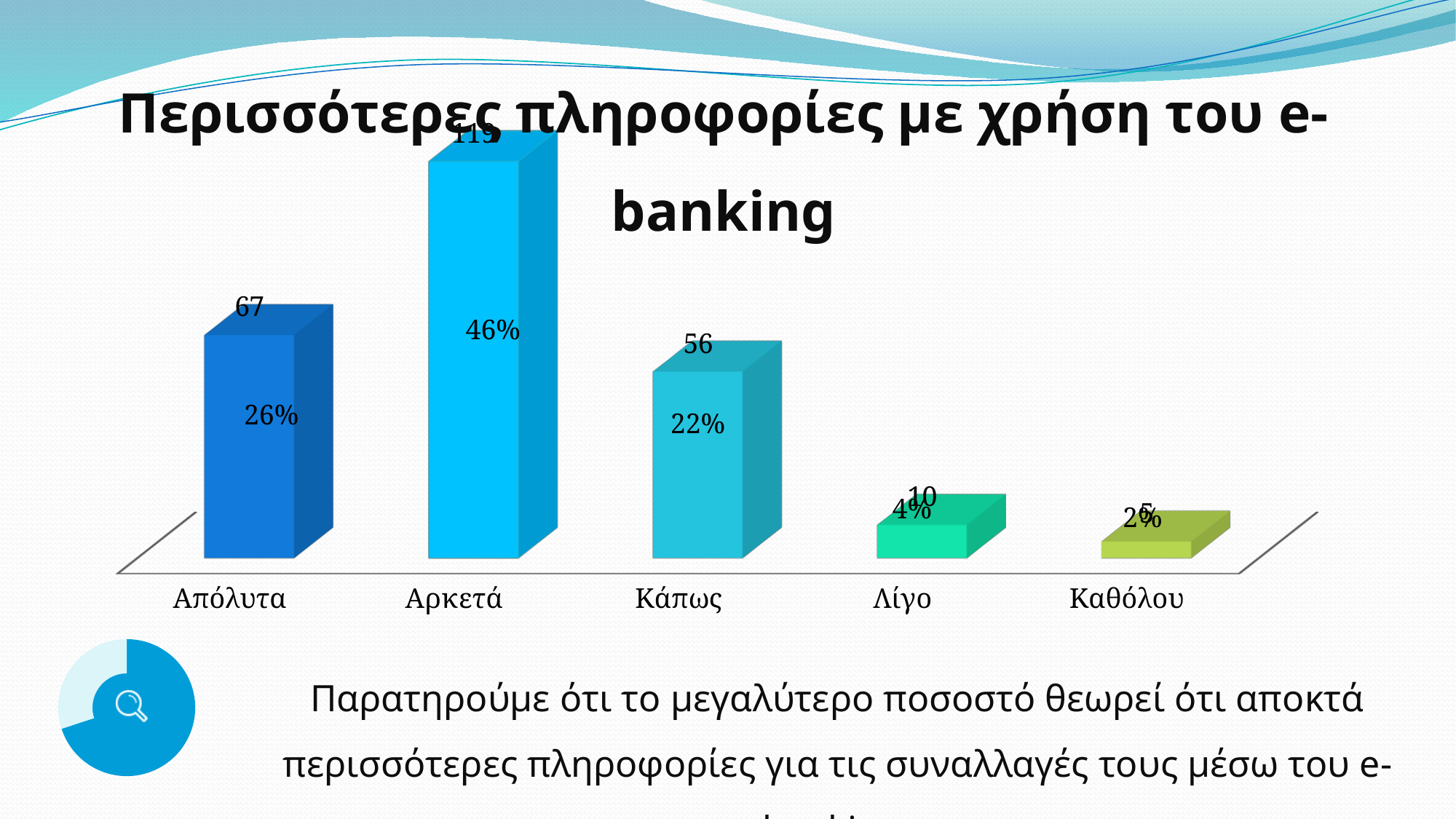
How many categories are shown on the x axis? 5 What is the count value shown for Απόλυτα? 67 What is the count value shown for Λίγο? 10 What is the count value shown for Κάπως? 56 What percentage is shown for Απόλυτα? 26% What percentage is shown for Καθόλου? 2% Which category has the highest bar? Αρκετά What percentage is shown for Αρκετά? 46% Which is larger, the value for Απόλυτα or the value for Κάπως? Απόλυτα What is the difference between the count values for Απόλυτα and Κάπως? 11 What percentage is shown for Κάπως? 22% Which category has the lowest bar? Καθόλου